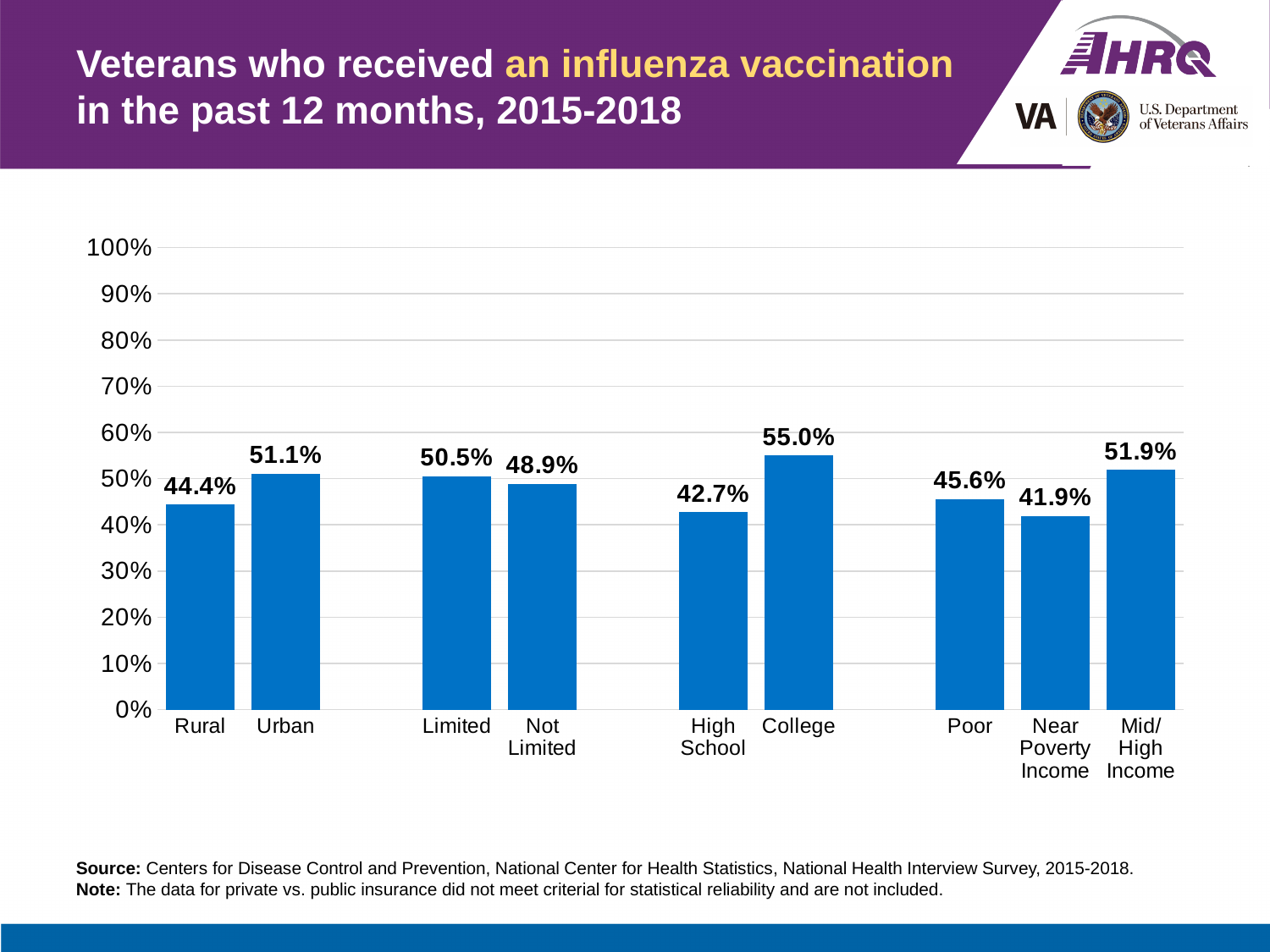
What is the value shown for College? 55.0% What is the highest value shown on the vertical axis? 100% What is the difference in percentage points between Urban and Rural? 6.7 What kind of chart is shown on the slide? Bar chart What is the value shown for Near Poverty Income? 41.9% How many categories are shown on the chart? 9 What percentage of Rural veterans received an influenza vaccination in the past 12 months? 44.4% What is the difference in percentage points between College and High School? 12.3 Which category has the highest percentage of veterans who received an influenza vaccination? College Which is larger, the value for Limited or the value for Not Limited? Limited Is the value for Poor greater or less than 50%? less Which category has the lowest percentage of veterans who received an influenza vaccination? Near Poverty Income